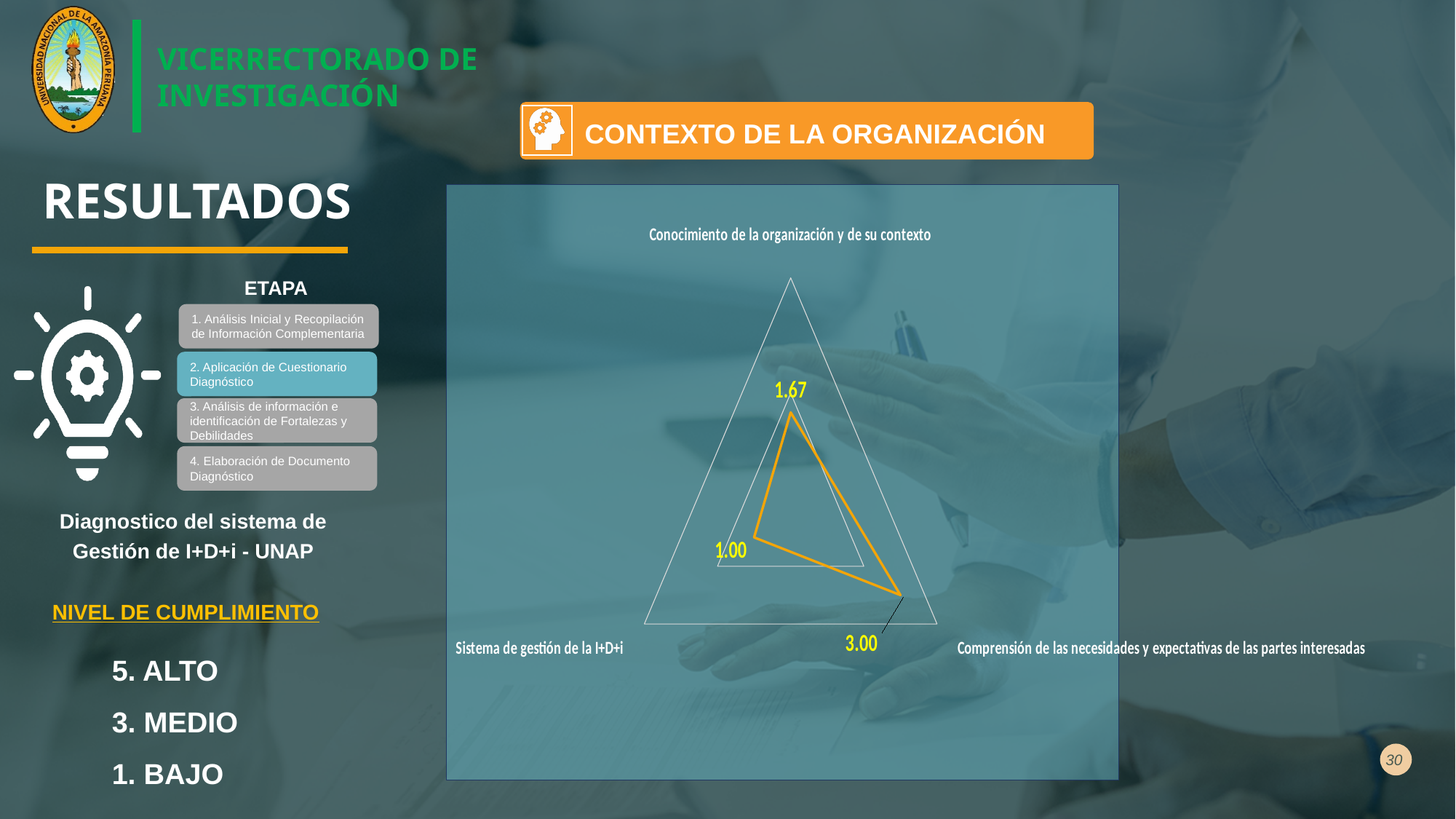
How many categories (axes) does the radar chart have? 3 What is the value for "Comprensión de las necesidades y expectativas de las partes interesadas"? 3.00 What colour is the data line plotted on the radar chart? Orange What is the difference between the values for "Conocimiento de la organización y de su contexto" and "Sistema de gestión de la I+D+i"? 0.67 Which category has the highest value in the radar chart? Comprensión de las necesidades y expectativas de las partes interesadas What is the value for "Conocimiento de la organización y de su contexto"? 1.67 What is the heading shown in the orange banner above the chart? CONTEXTO DE LA ORGANIZACIÓN What is the value for "Sistema de gestión de la I+D+i"? 1.00 What type of chart is shown on the slide? Radar chart What is the difference between the values for "Comprensión de las necesidades y expectativas de las partes interesadas" and "Sistema de gestión de la I+D+i"? 2.00 Which category has the lowest value in the radar chart? Sistema de gestión de la I+D+i Which is larger: the value for "Conocimiento de la organización y de su contexto" or the value for "Comprensión de las necesidades y expectativas de las partes interesadas"? Comprensión de las necesidades y expectativas de las partes interesadas